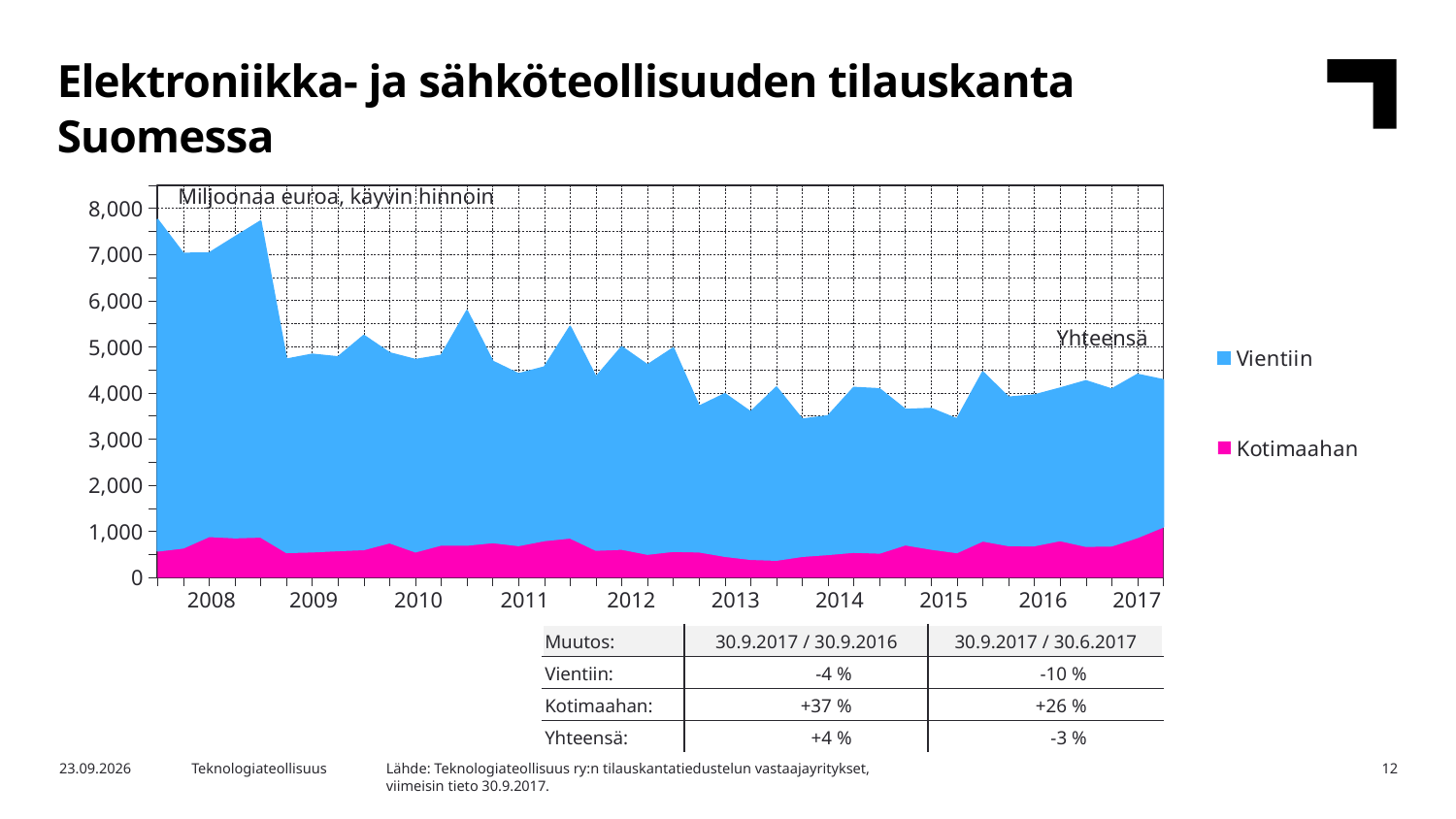
Does the total order stock rise or fall overall from 2008 to 2017? fall In the table below the chart, what is the change for Yhteensä between 30.6.2017 and 30.9.2017? -3 % What unit label is shown at the top of the chart area? Miljoonaa euroa, käyvin hinnoin What kind of chart is shown on the slide? Stacked area chart Is the Kotimaahan value in 2013 greater or less than 1,000? less How many years are labelled on the x axis? 10 Is the total order stock at the start of 2008 greater or less than 7,000? greater In the table below the chart, what is the change for Kotimaahan between 30.9.2016 and 30.9.2017? +37 % Which series is larger throughout the chart, Vientiin or Kotimaahan? Vientiin Is the total order stock at the end of 2017 greater or less than 5,000? less How many series does the legend list? 2 What are the two series named in the legend? Vientiin and Kotimaahan